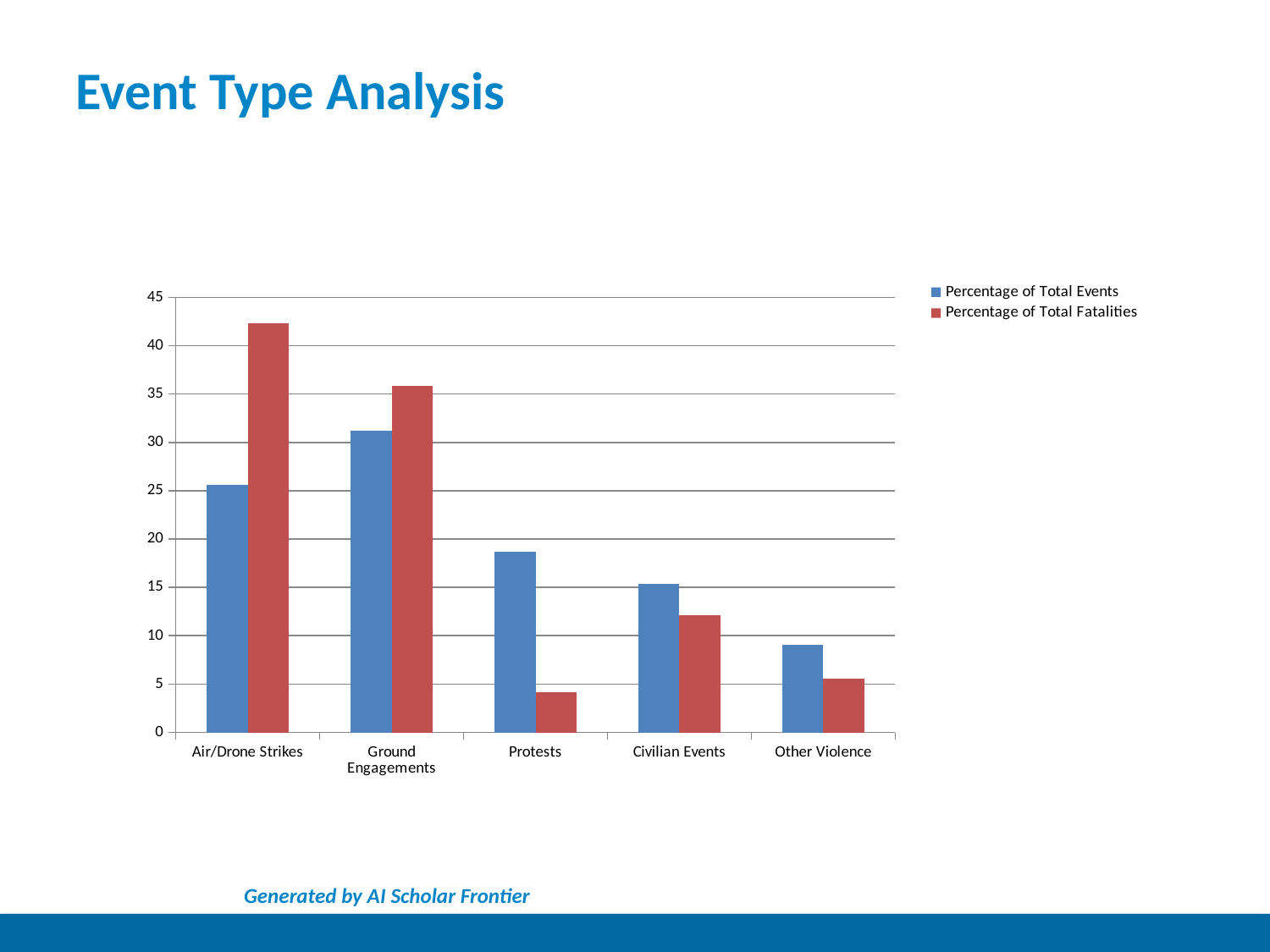
Which event type has the lowest Percentage of Total Events? Other Violence How many event type categories are shown on the x axis? 5 Which event type has the highest Percentage of Total Fatalities? Air/Drone Strikes For Protests, which is larger: Percentage of Total Events or Percentage of Total Fatalities? Percentage of Total Events Which event type has the highest Percentage of Total Events? Ground Engagements Which event type has the lowest Percentage of Total Fatalities? Protests What colour represents Percentage of Total Fatalities in the legend? red What kind of chart is shown on the slide? bar chart How many series does the legend list? 2 Is the Percentage of Total Events for Protests greater or less than 20? less For Air/Drone Strikes, which is larger: Percentage of Total Events or Percentage of Total Fatalities? Percentage of Total Fatalities Is the Percentage of Total Fatalities for Air/Drone Strikes greater or less than 40? greater